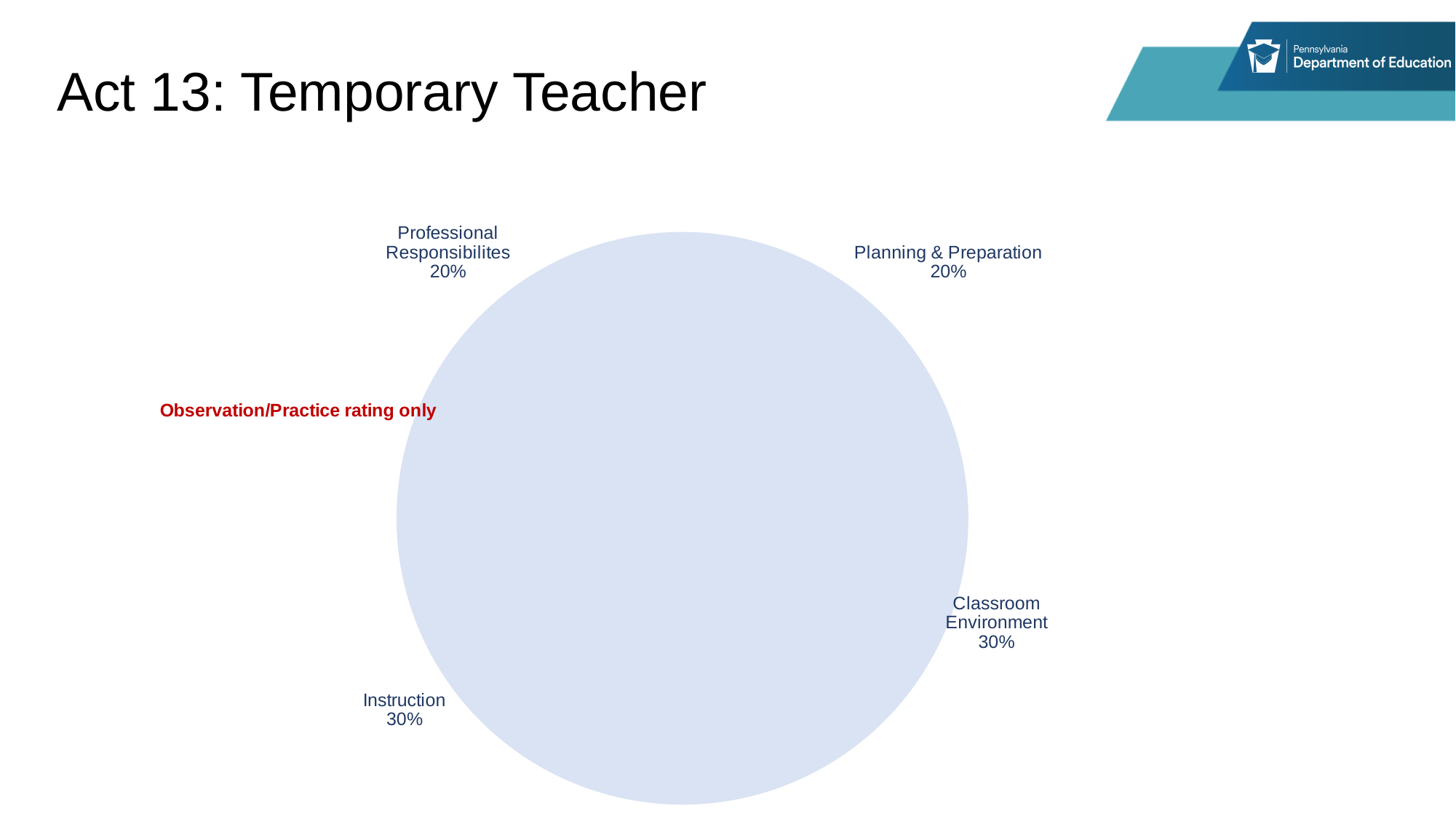
What is the difference in percentage points between Classroom Environment and Planning & Preparation? 10 What is the combined share of Instruction and Classroom Environment? 60% Which is larger, the share for Classroom Environment or the share for Professional Responsibilites? Classroom Environment What kind of chart is shown on the slide? pie chart What does the red text to the left of the pie chart say? Observation/Practice rating only What percentage is shown for Classroom Environment? 30% Which is larger, the share for Instruction or the share for Planning & Preparation? Instruction What percentage is shown for Professional Responsibilites? 20% What is the title of the slide containing the pie chart? Act 13: Temporary Teacher What percentage is shown for Planning & Preparation? 20% What percentage is shown for Instruction? 30% How many categories does the pie chart show? 4